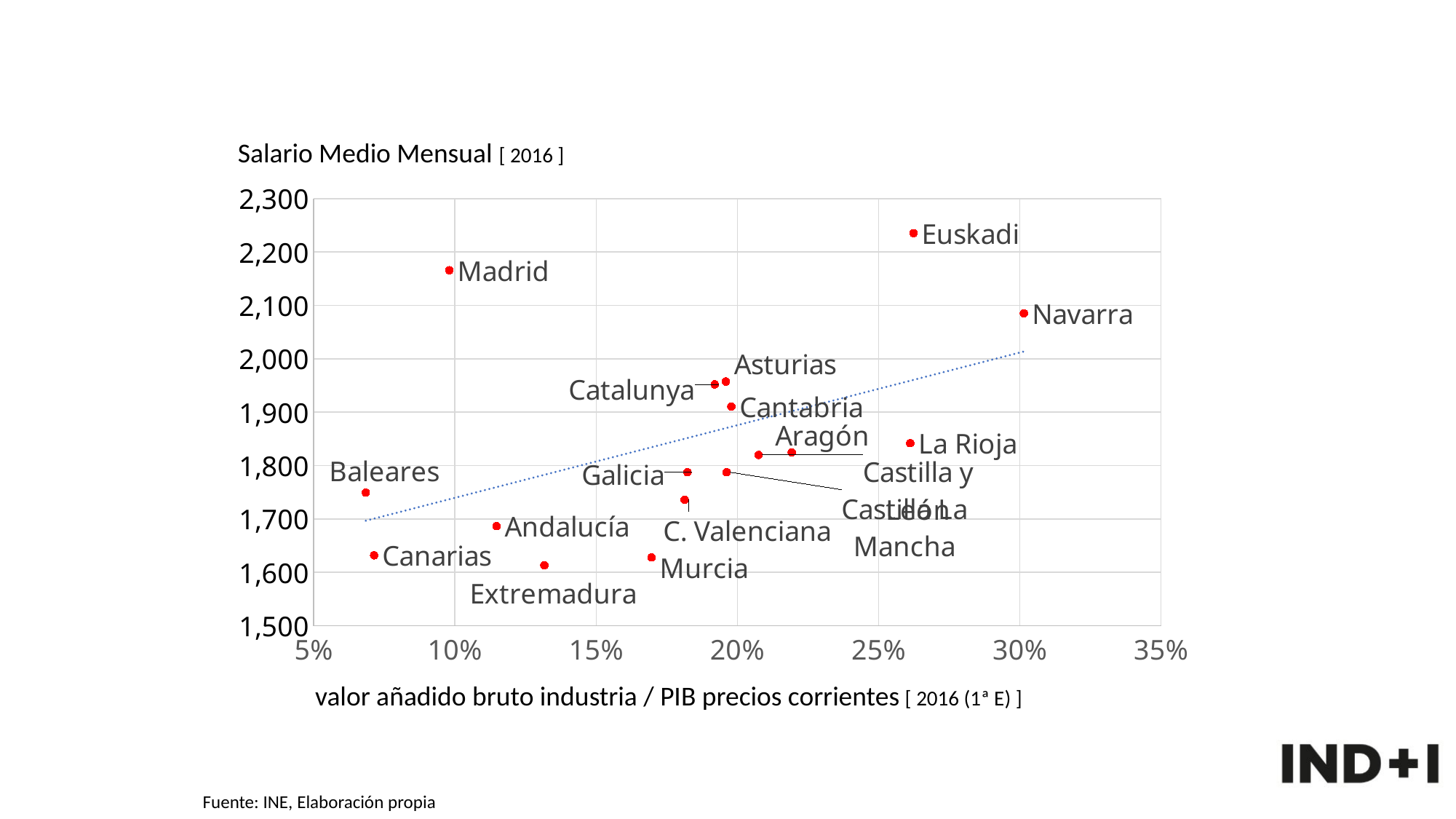
Is the Salario Medio Mensual for Euskadi greater or less than 2,200? greater Does the dotted trend line rise or fall as the horizontal-axis value increases? rises Which has a higher Salario Medio Mensual, Baleares or Andalucía? Baleares Is the horizontal-axis value for Navarra greater or less than 25%? greater Is the Salario Medio Mensual for Madrid greater or less than 2,100? greater Which region has the highest Salario Medio Mensual? Euskadi What kind of chart is shown on the slide? scatter chart How many regions are plotted on the chart? 17 Which region has the highest value on the horizontal axis (valor añadido bruto industria / PIB)? Navarra Which has a higher Salario Medio Mensual, Madrid or Navarra? Madrid